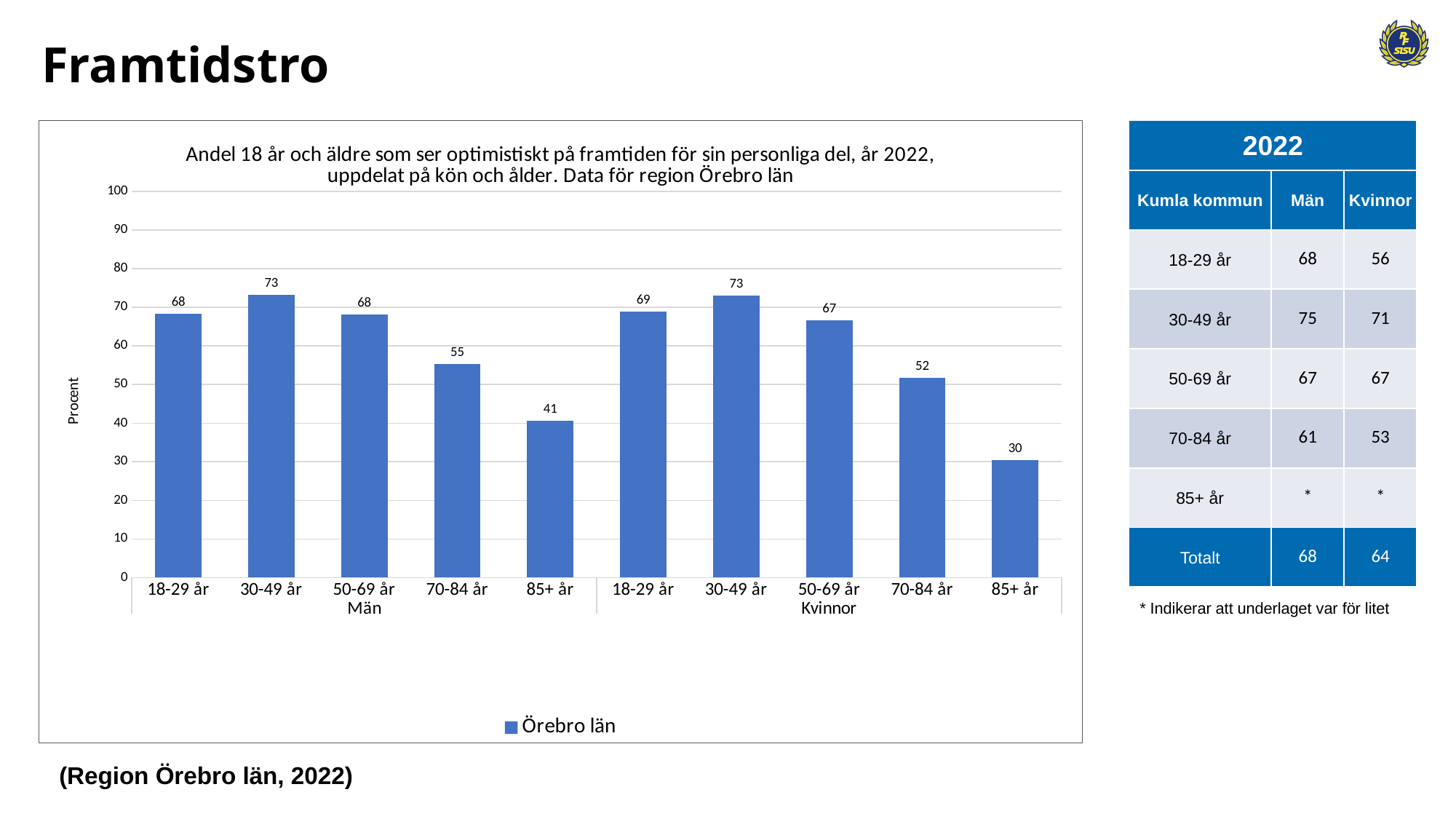
What is the value for women aged 85+ år in the chart? 30 How many series does the legend list? 1 What is the difference between the values for men aged 30-49 år and men aged 70-84 år? 18 Which is larger: the value for men aged 70-84 år or women aged 70-84 år? Men aged 70-84 år What kind of chart is shown on the slide? Bar chart What is the difference between the values for men aged 85+ år and women aged 85+ år? 11 Which age group has the lowest value among women in the chart? 85+ år Which age group has the highest value among men in the chart? 30-49 år What is the legend entry of the chart? Örebro län What is the value for women aged 18-29 år in the chart? 69 What is the value for men aged 70-84 år in the chart? 55 How many bars are plotted in the chart? 10